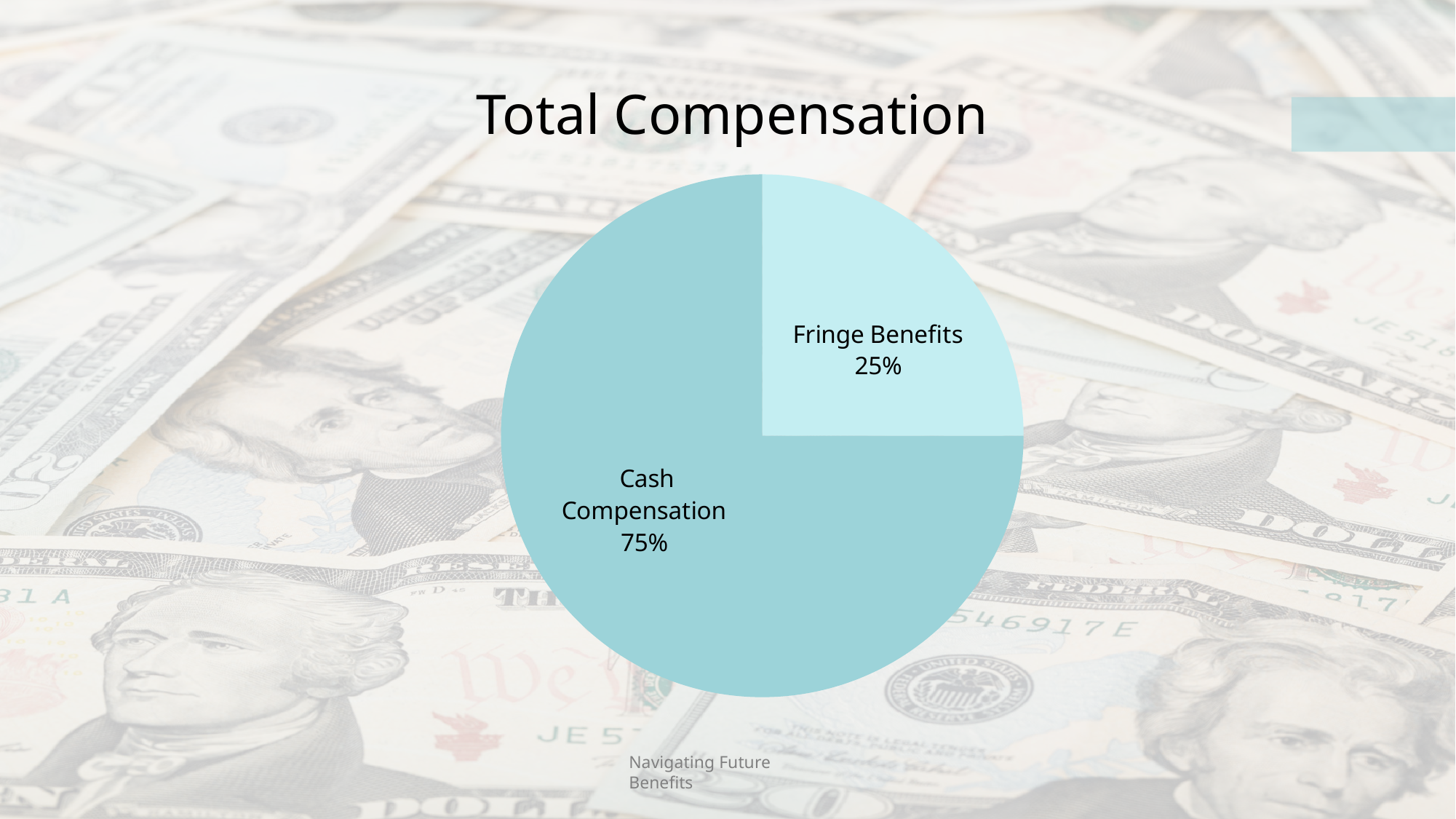
Is the value for Fringe Benefits greater or less than 50%? less Which slice is shown in the lighter shade of blue? Fringe Benefits Which slice is the largest? Cash Compensation Which is larger, Cash Compensation or Fringe Benefits? Cash Compensation What share of the pie is Cash Compensation? 75% How many slices does the pie chart have? 2 What is the difference in percentage points between Cash Compensation and Fringe Benefits? 50 What share of the pie is Fringe Benefits? 25% What kind of chart is shown on the slide? pie chart What is the title of the chart? Total Compensation Which slice is the smallest? Fringe Benefits